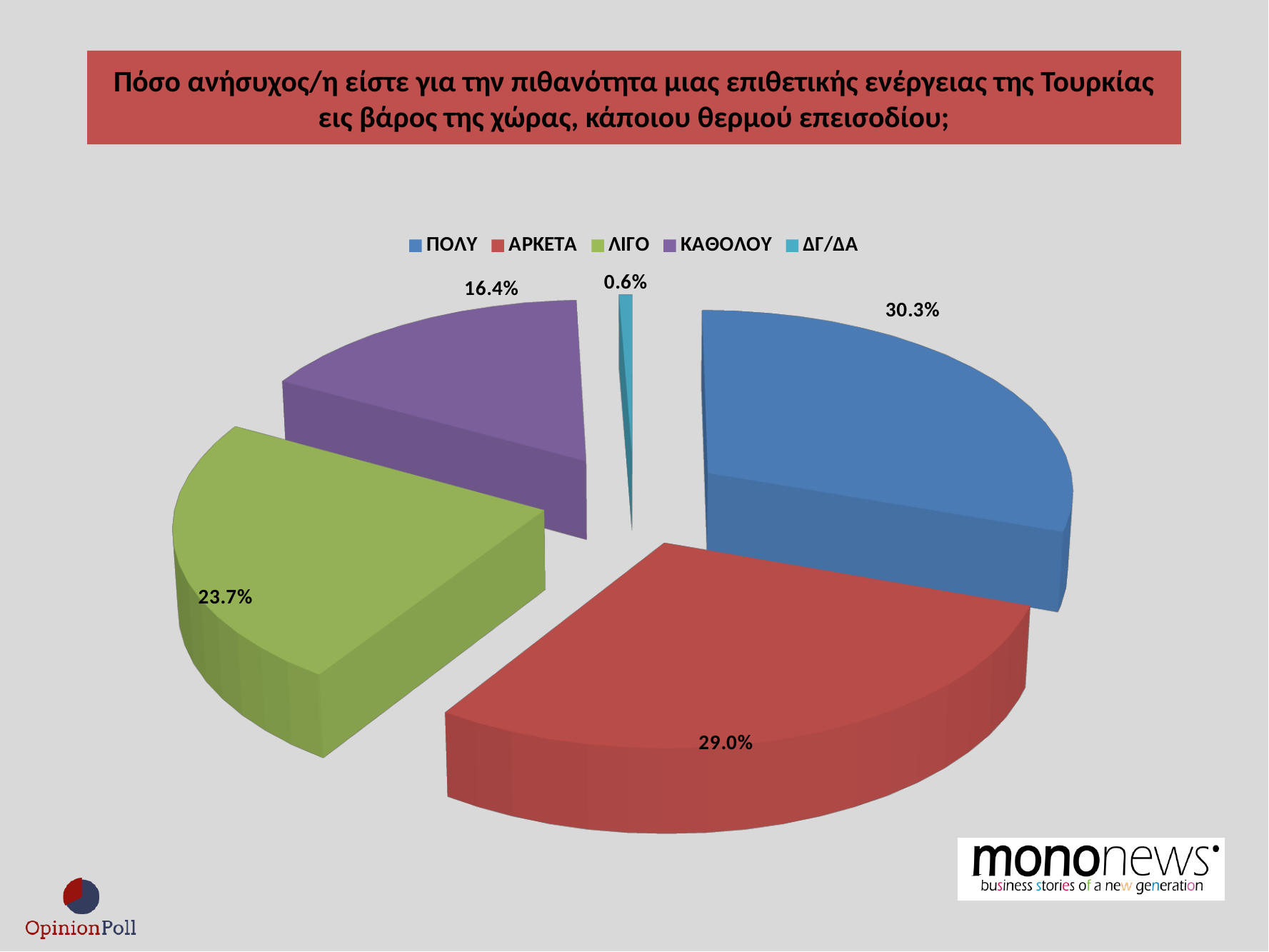
Which response category has the smallest share of the pie? ΔΓ/ΔΑ Which response category has the largest share of the pie? ΠΟΛΥ What percentage of respondents answered ΔΓ/ΔΑ? 0.6% What percentage of respondents answered ΠΟΛΥ? 30.3% What is the difference in percentage points between ΠΟΛΥ and ΚΑΘΟΛΟΥ? 13.9 How many categories does the legend list? 5 What kind of chart is shown on the slide? Pie chart What percentage of respondents answered ΚΑΘΟΛΟΥ? 16.4% Which is larger, the share for ΛΙΓΟ or the share for ΚΑΘΟΛΟΥ? ΛΙΓΟ What percentage of respondents answered ΑΡΚΕΤΑ? 29.0% What percentage of respondents answered ΛΙΓΟ? 23.7% What colour is the slice for ΑΡΚΕΤΑ? Red